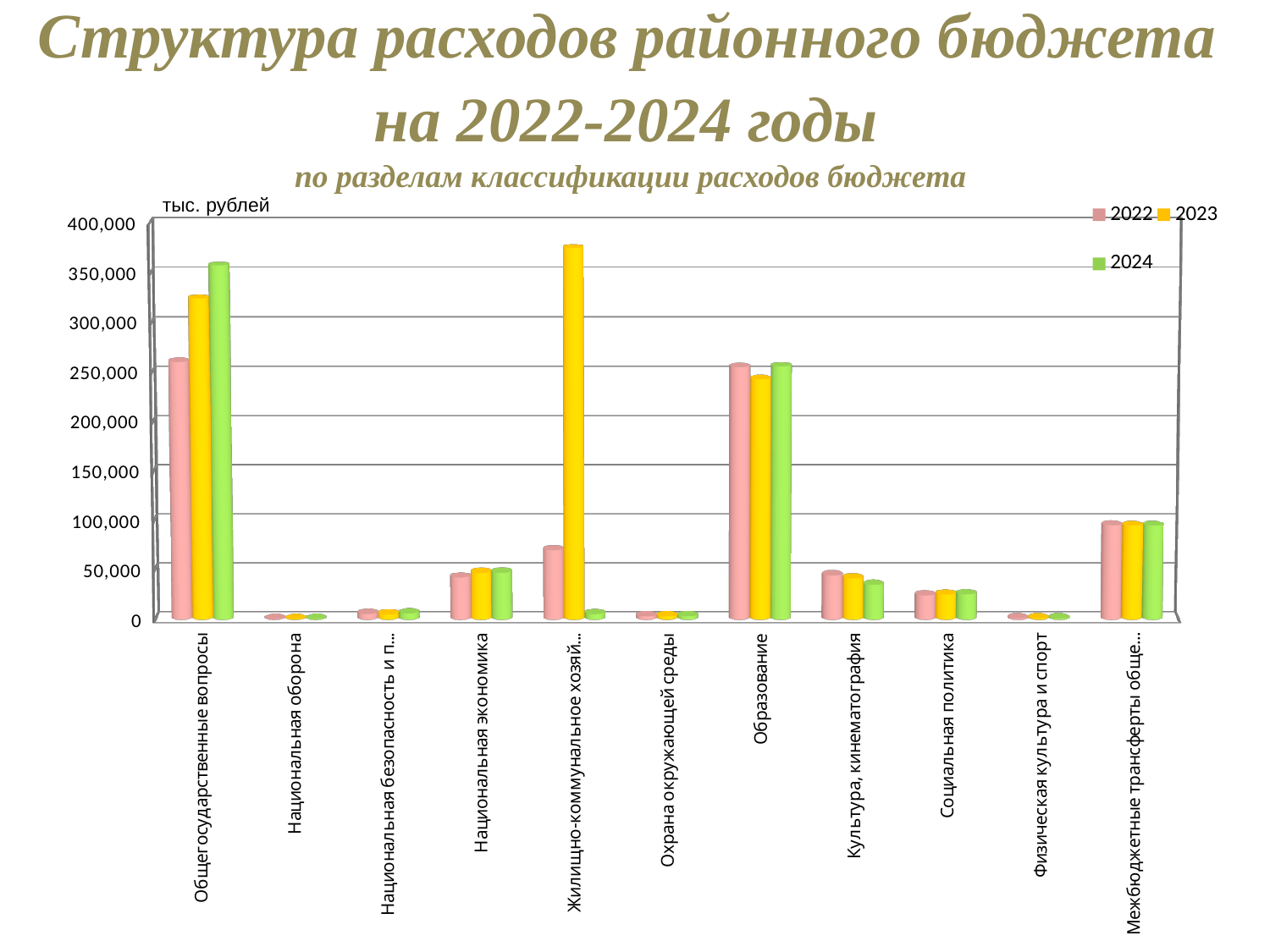
Is the 2024 value for Общегосударственные вопросы greater or less than 300,000? greater In what units are the values on the y axis expressed? тыс. рублей Do the values for Общегосударственные вопросы rise or fall from 2022 to 2024? Rise How many series does the legend list? 3 Is the 2022 value for Образование greater or less than 200,000? greater Which is larger in 2024: the value for Общегосударственные вопросы or the value for Образование? Общегосударственные вопросы Is the 2023 value for Национальная экономика greater or less than 100,000? less Which year is shown in yellow in the legend? 2023 How many expenditure categories are shown along the x axis? 11 Which year has the highest value for Общегосударственные вопросы? 2024 What kind of chart is shown on the slide? Bar chart